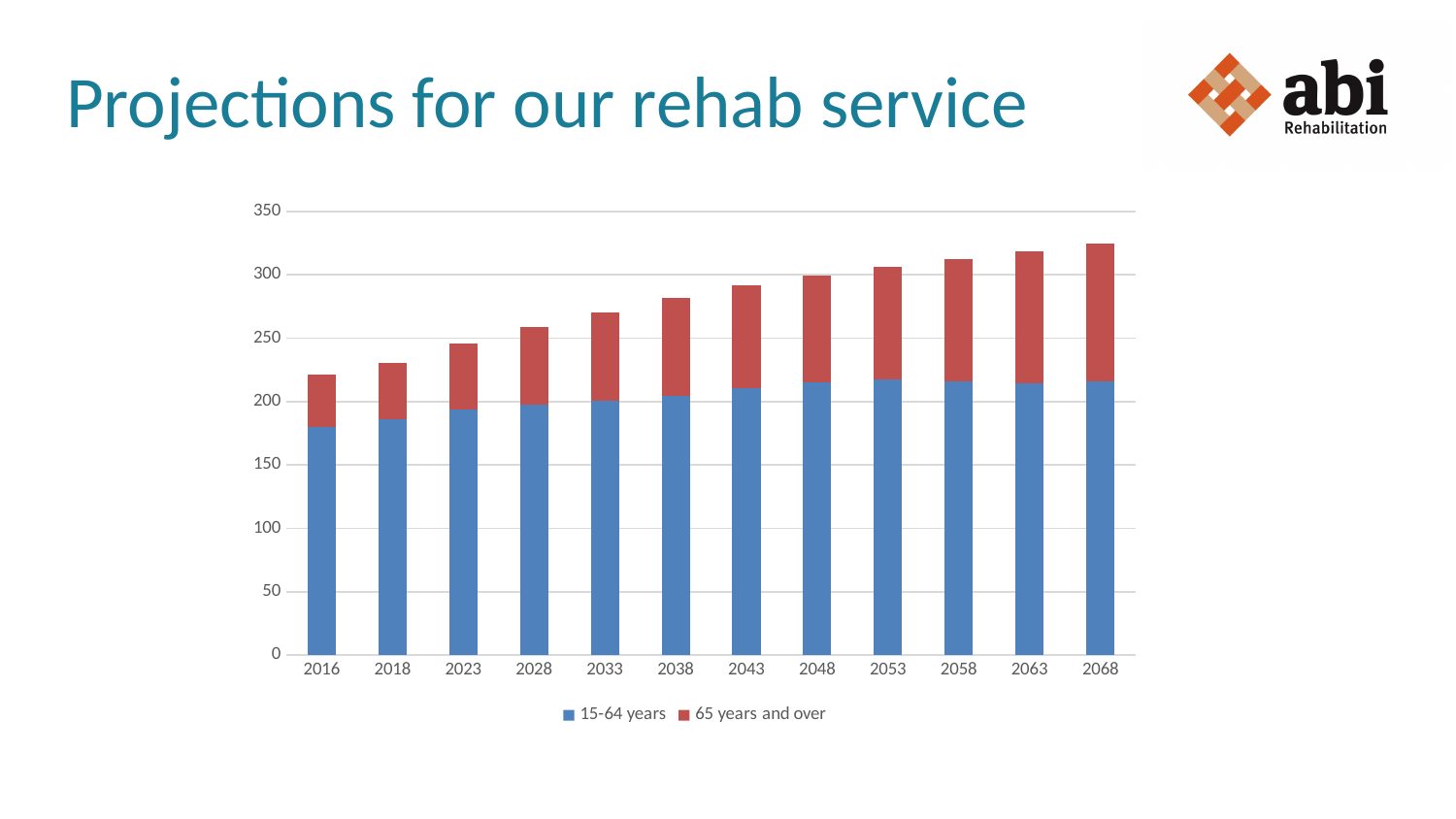
Do the total bar heights rise or fall from 2016 to 2068? rise What kind of chart is shown on the slide? stacked bar chart Which year has the highest total bar in the chart? 2068 Which year has the lowest total bar in the chart? 2016 Is the total bar for 2068 greater or less than 300? greater What are the two series named in the chart's legend? 15-64 years and 65 years and over Is the total bar for 2016 greater or less than 250? less How many series does the chart's legend list? 2 Which year has the larger total bar, 2016 or 2068? 2068 How many years are shown along the x axis of the chart? 12 Is the total bar for 2043 greater or less than 300? less